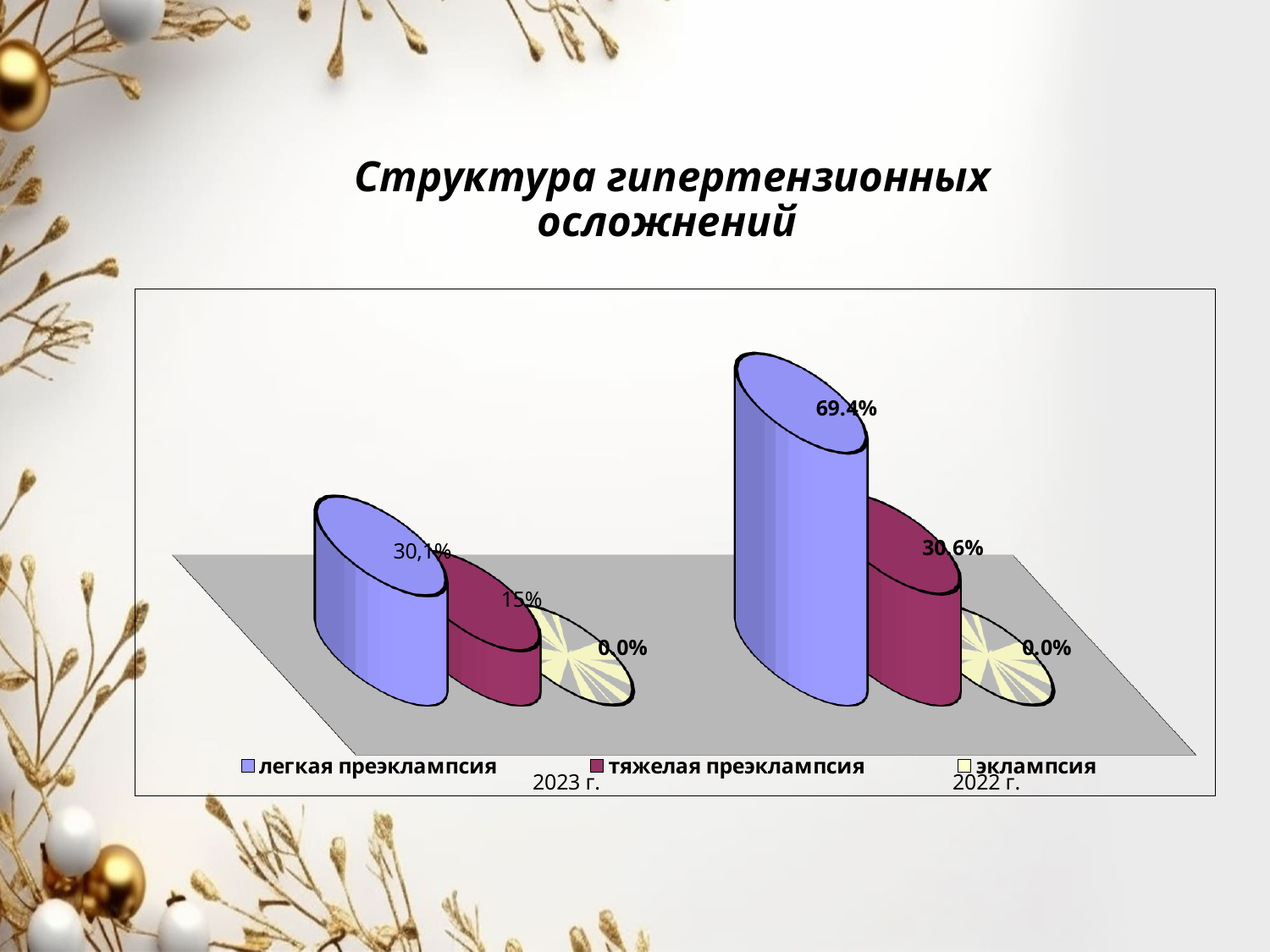
What is the value for тяжелая преэклампсия in 2023 г.? 15% Which series has the lowest value in 2023 г.? эклампсия What is the title of the chart? Структура гипертензионных осложнений What is the value for легкая преэклампсия in 2022 г.? 69.4% How many series does the legend list? 3 What kind of chart is shown on the slide? bar chart What is the value for тяжелая преэклампсия in 2022 г.? 30.6% Which series has the highest value in 2022 г.? легкая преэклампсия What is the value for эклампсия in 2022 г.? 0.0% Which is larger: легкая преэклампсия in 2022 г. or легкая преэклампсия in 2023 г.? 2022 г. What is the value for легкая преэклампсия in 2023 г.? 30,1% What is the difference between легкая преэклампсия and тяжелая преэклампсия in 2022 г.? 38.8%